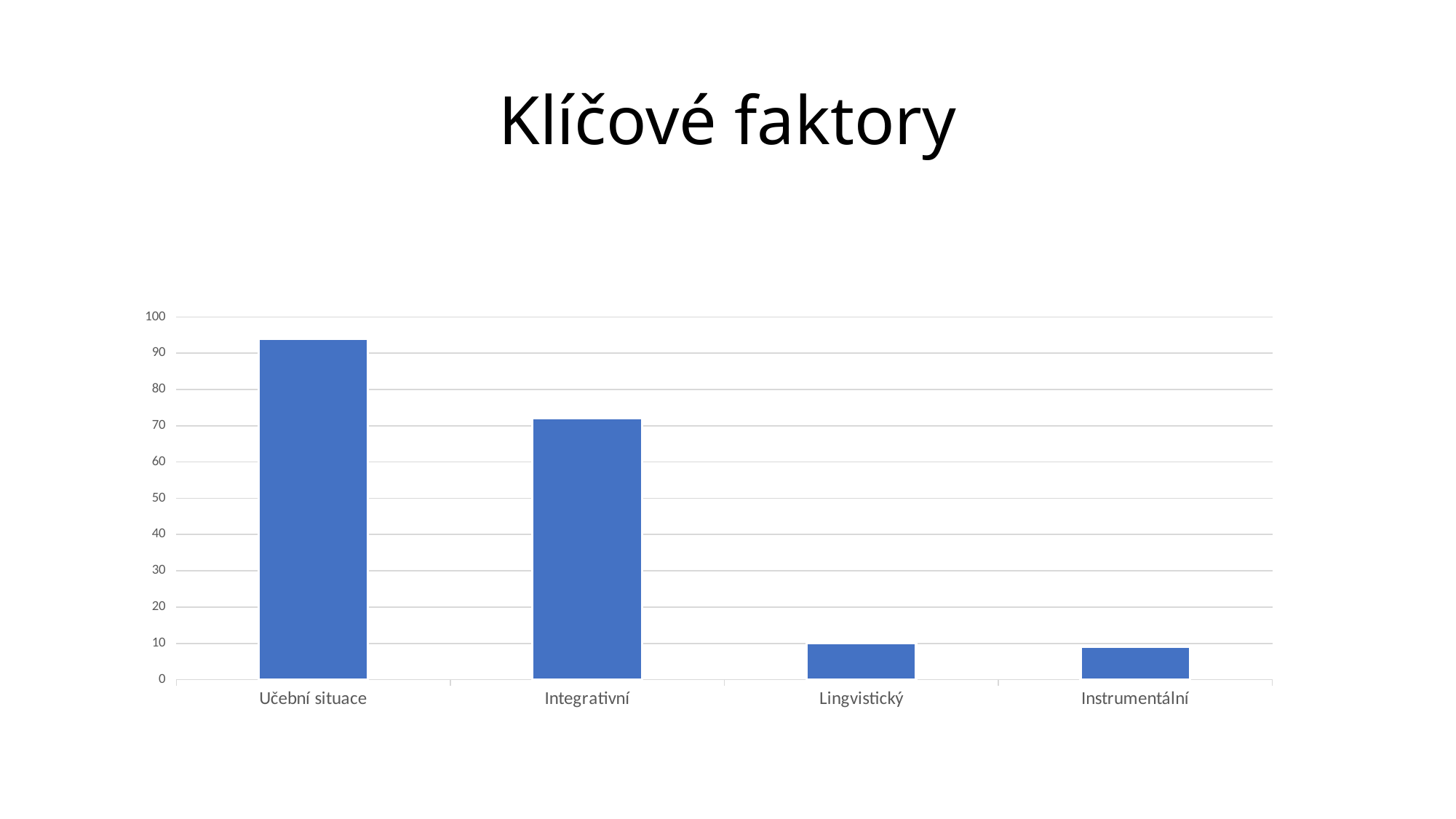
Which category has the highest bar in the chart? Učební situace Which is larger, the value for Integrativní or the value for Lingvistický? Integrativní What is the title of the slide containing the chart? Klíčové faktory What kind of chart is shown on the slide? bar chart How many categories are shown on the x axis of the chart? 4 Is the value for Integrativní greater or less than 80? less Is the value for Integrativní greater or less than 60? greater Which is larger, the value for Učební situace or the value for Integrativní? Učební situace Is the value for Učební situace greater or less than 90? greater Do the bar values rise or fall from left to right along the x axis? fall